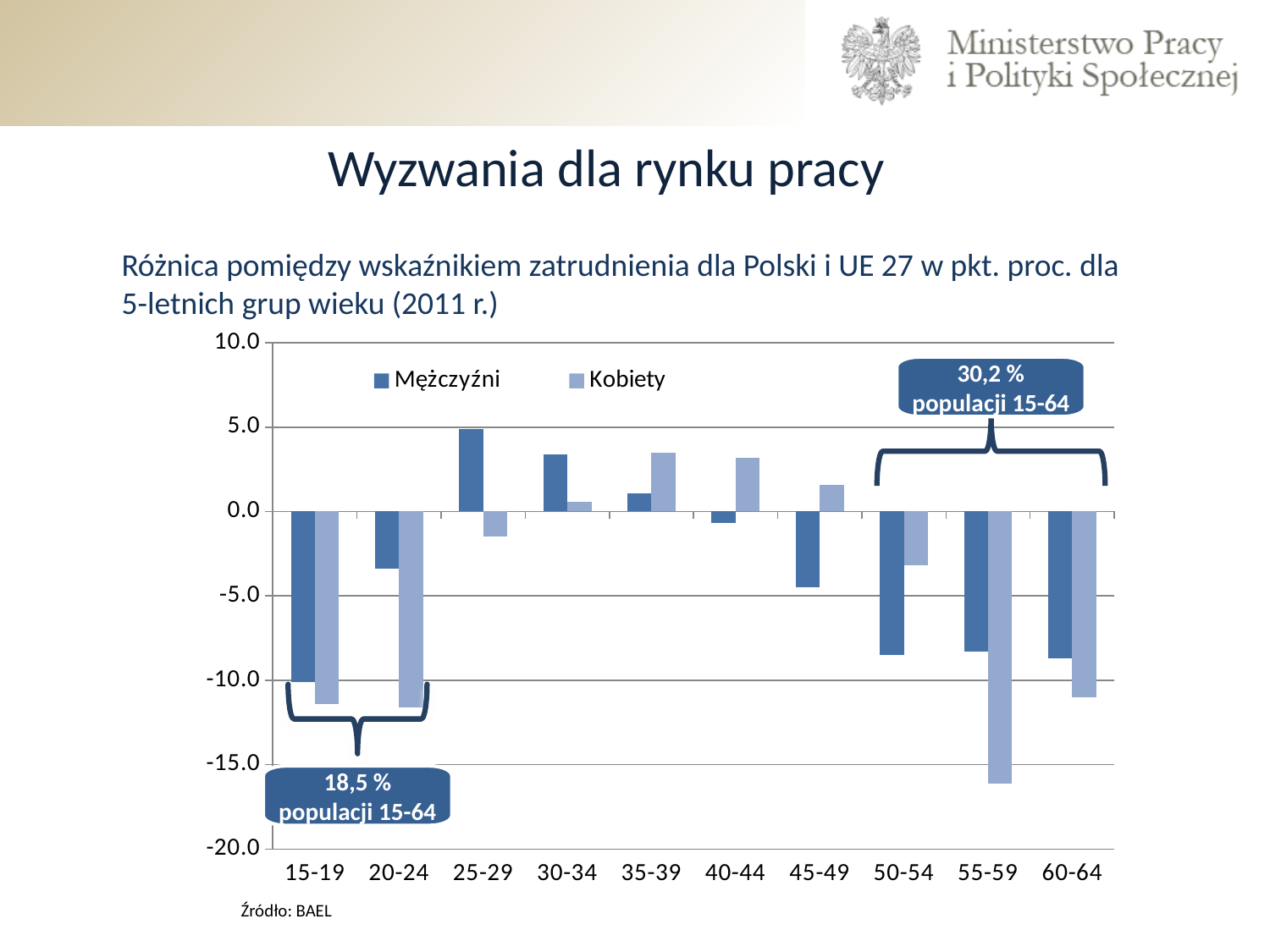
Is the value for Kobiety in the 20-24 age group greater or less than -10.0? less Is the value for Mężczyźni in the 50-54 age group greater or less than -5.0? less What kind of chart is shown on the slide? bar chart Is the value for Kobiety in the 55-59 age group greater or less than -15.0? less How many age groups are shown on the x axis of the chart? 10 How many series does the chart legend list? 2 What share of the 15-64 population does the annotation above the 50-54 to 60-64 age groups state? 30,2 % Which age group and series has the lowest value in the chart? Kobiety, 55-59 Which age group has the highest value for Mężczyźni? 25-29 In the 45-49 age group, which series has the larger value, Mężczyźni or Kobiety? Kobiety In the 20-24 age group, which series has the larger value, Mężczyźni or Kobiety? Mężczyźni What are the two series named in the chart legend? Mężczyźni and Kobiety